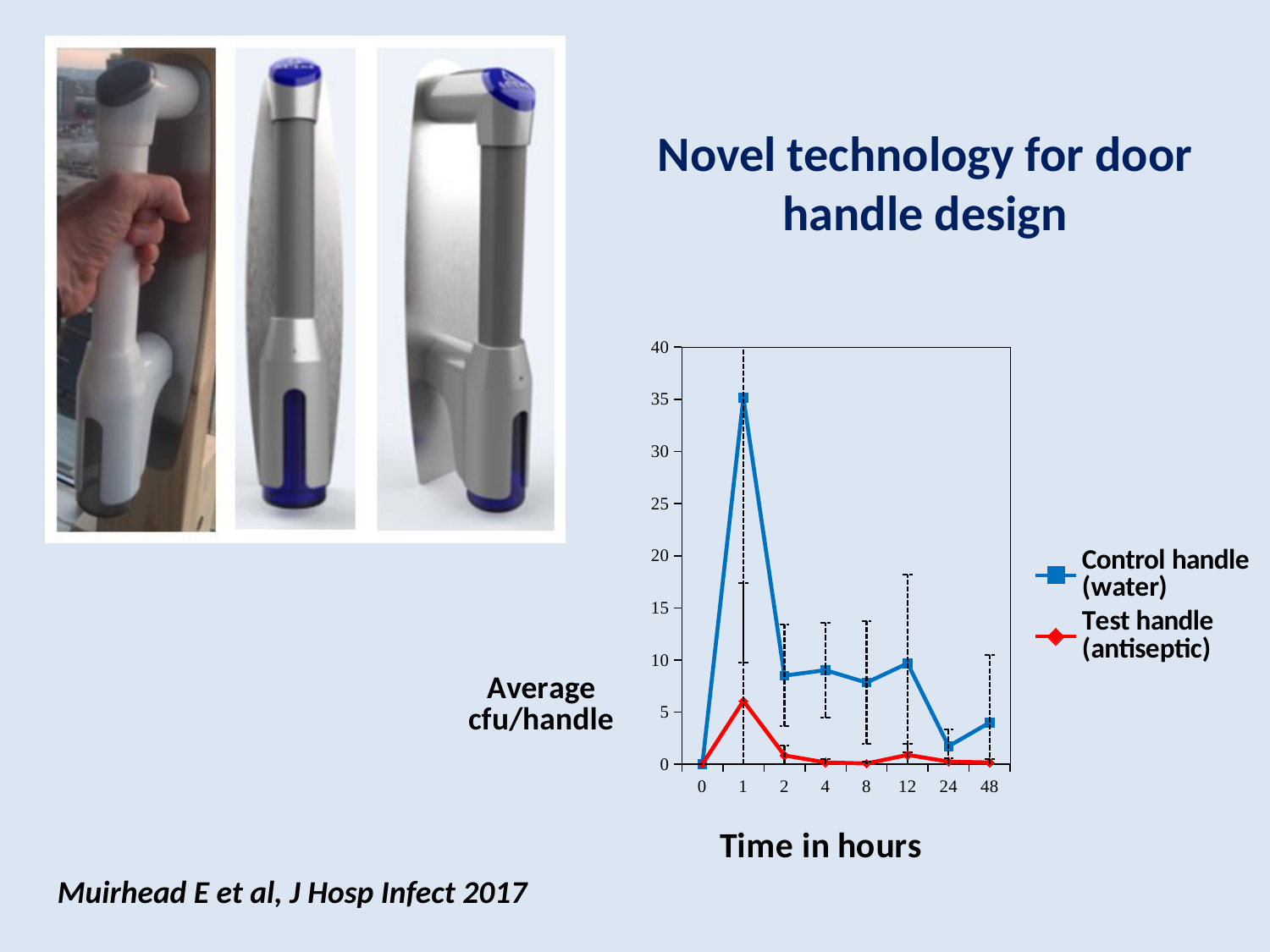
What is the label on the y axis of the chart? Average cfu/handle At 12 hours, which series has the higher value, Control handle (water) or Test handle (antiseptic)? Control handle (water) What kind of chart is shown on the slide? line chart What is the value for the Control handle (water) at 0 hours? 0 Is the value for the Control handle (water) at 24 hours greater or less than 5? less Is the value for the Control handle (water) at 2 hours greater or less than 15? less Is the value for the Control handle (water) at 1 hour greater or less than 30? greater How many series does the chart legend list? 2 At which time in hours does the Control handle (water) series reach its highest value? 1 Does the Control handle (water) series rise or fall between 12 and 24 hours? fall How many time points are plotted along the x axis of the chart? 8